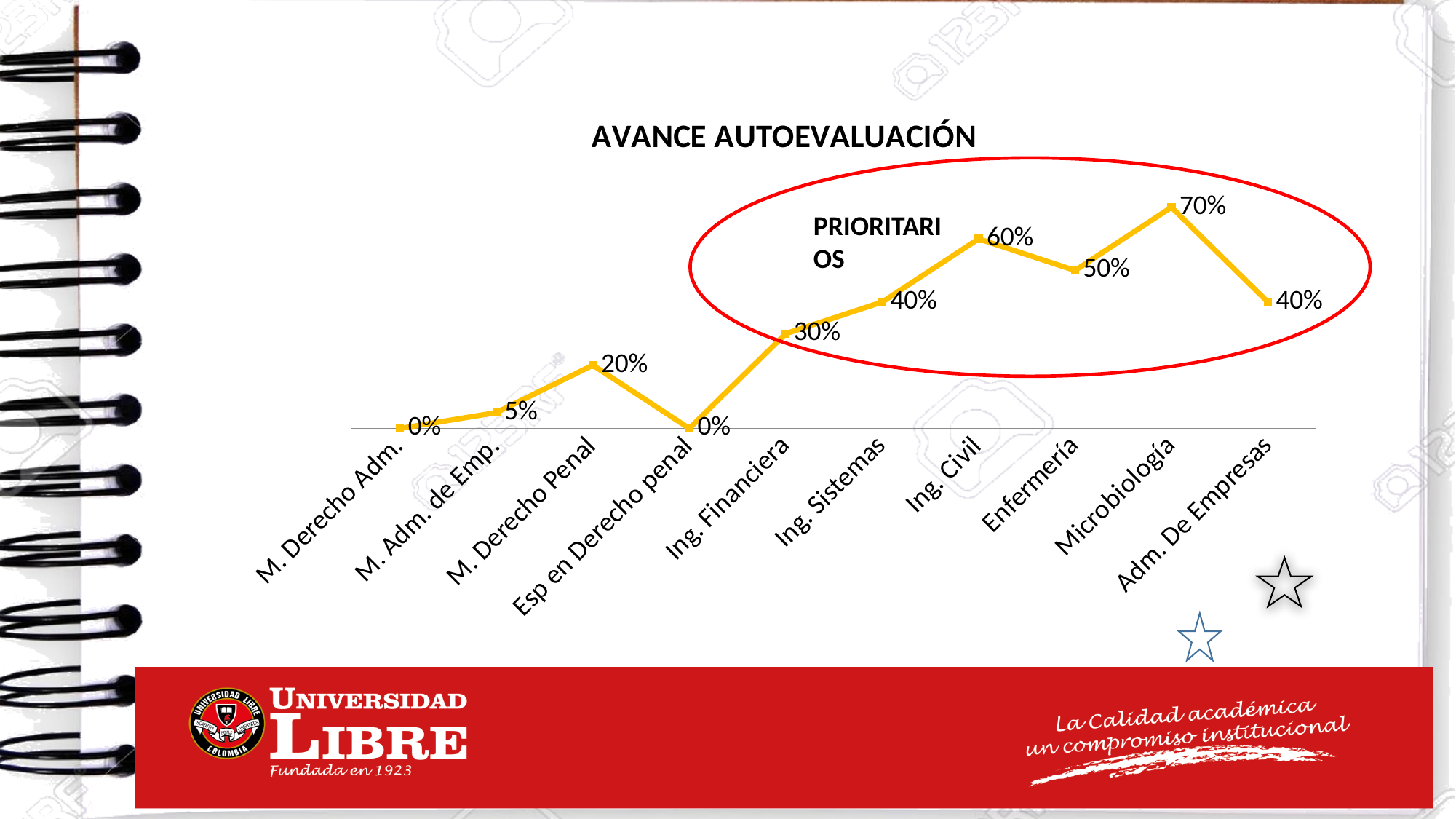
What is the title of the chart? AVANCE AUTOEVALUACIÓN What is the difference between the values for Microbiología and Adm. De Empresas? 30% What is the value for Ing. Financiera? 30% How many categories are plotted on the x axis? 10 Do the values rise or fall from Ing. Financiera to Ing. Civil? rise What is the value for M. Adm. de Emp.? 5% What is the value for Microbiología? 70% Which category has the highest value? Microbiología What is the difference between the values for Ing. Civil and Ing. Sistemas? 20% What type of chart is shown on the slide? line chart What is the value for Enfermería? 50% Which is larger, the value for M. Derecho Penal or the value for Adm. De Empresas? Adm. De Empresas